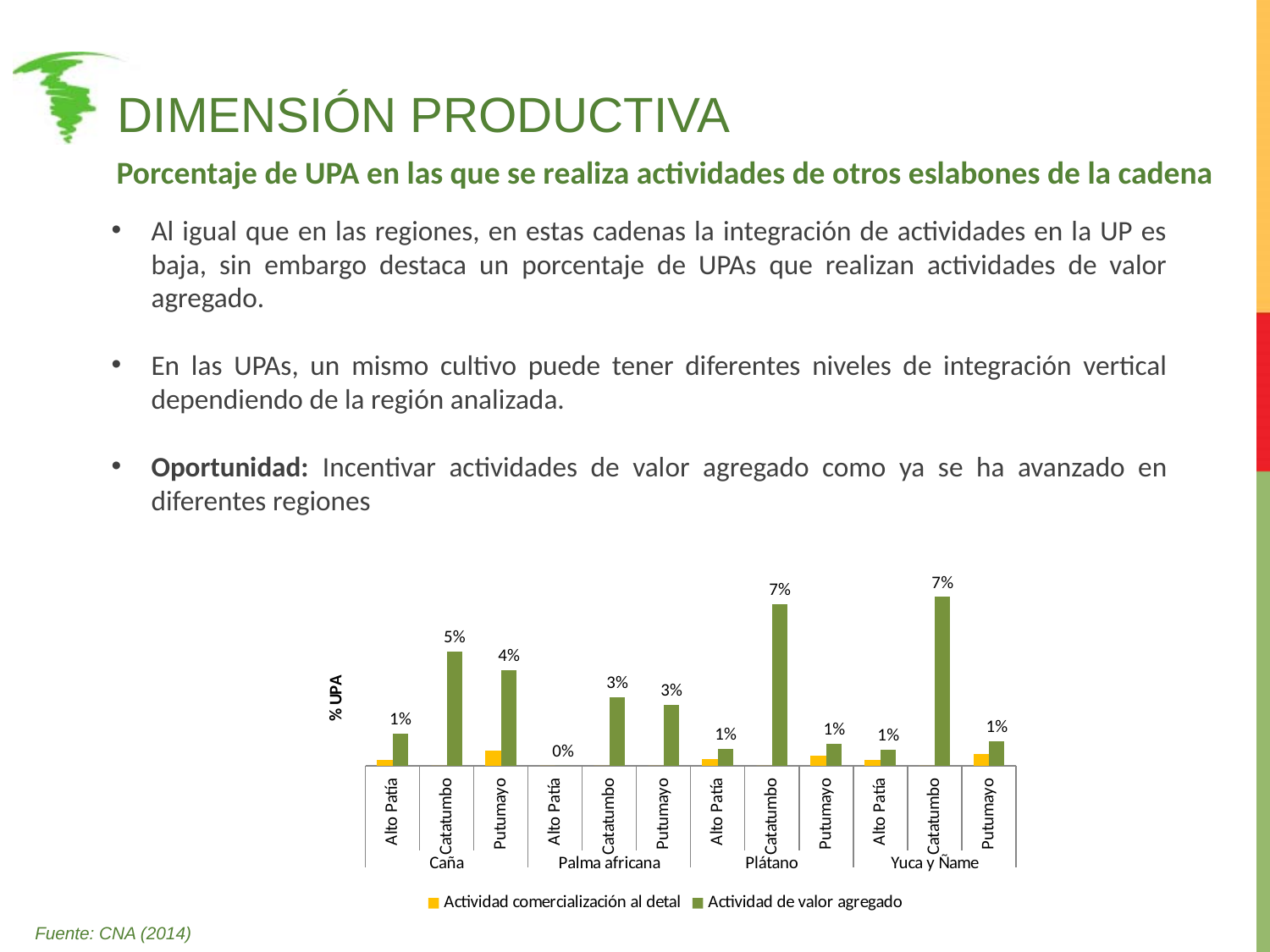
Which is larger: the Actividad de valor agregado value for Catatumbo in Caña or for Catatumbo in Palma africana? Catatumbo in Caña How many crop groups are shown on the x axis of the chart? 4 What is the value of Actividad de valor agregado for Alto Patía in the Palma africana group? 0% What is the value of Actividad de valor agregado for Catatumbo in the Caña group? 5% Within the Caña group, which region has the highest Actividad de valor agregado value? Catatumbo What is the difference between the Actividad de valor agregado values for Catatumbo and Putumayo in the Caña group? 1% What is the label on the vertical axis of the chart? % UPA What is the value of Actividad de valor agregado for Catatumbo in the Plátano group? 7% What is the value of Actividad de valor agregado for Putumayo in the Caña group? 4% What kind of chart is shown on the slide? bar chart Which region and crop combination has the lowest Actividad de valor agregado value? Alto Patía, Palma africana How many series does the chart legend list? 2